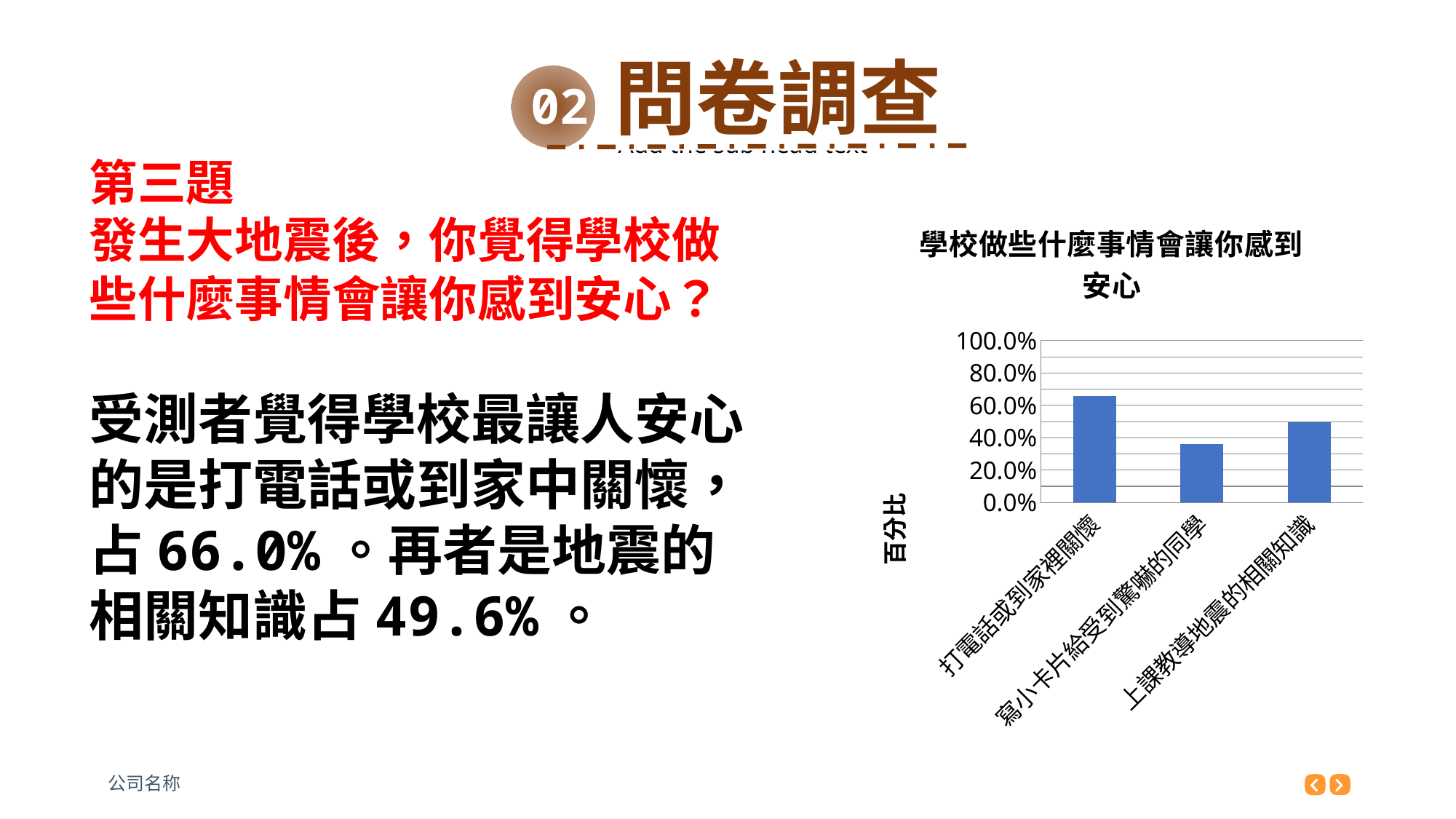
Which category has the lowest value in the chart? 寫小卡片給受到驚嚇的同學 Which is larger: the value for 寫小卡片給受到驚嚇的同學 or the value for 上課教導地震的相關知識? 上課教導地震的相關知識 How many categories are plotted in the chart? 3 Which category has the highest value in the chart? 打電話或到家裡關懷 Is the value for 寫小卡片給受到驚嚇的同學 greater or less than 20.0%? greater Which is larger: the value for 打電話或到家裡關懷 or the value for 上課教導地震的相關知識? 打電話或到家裡關懷 What is the title of the chart? 學校做些什麼事情會讓你感到安心 Is the value for 上課教導地震的相關知識 greater or less than 40.0%? greater Is the value for 打電話或到家裡關懷 greater or less than 60.0%? greater What is the label on the vertical axis of the chart? 百分比 What kind of chart is shown on the slide? bar chart